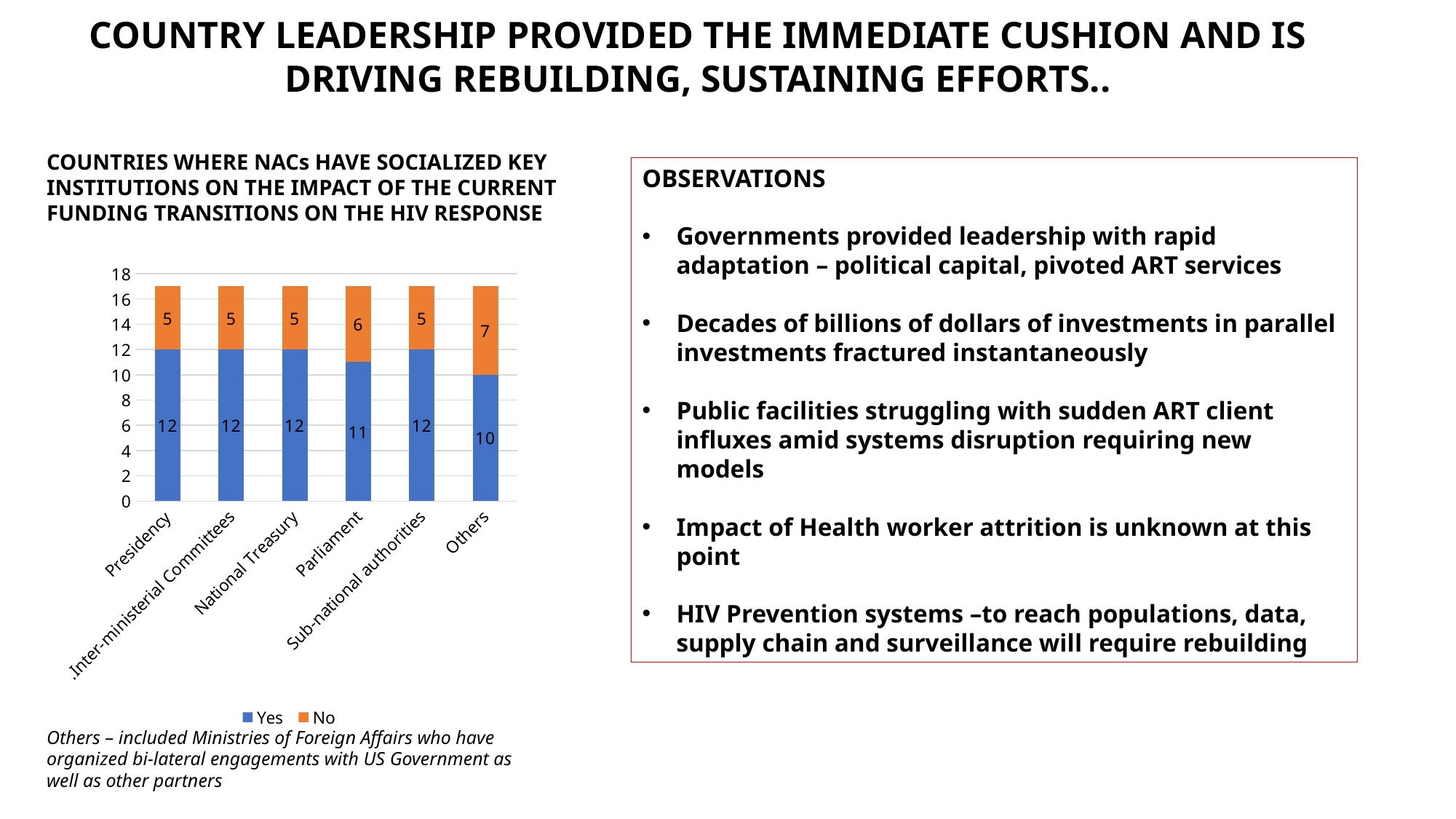
How many categories are shown on the x axis? 6 What is the 'Yes' value for Others? 10 What is the 'Yes' value for Presidency? 12 What is the 'No' value for Parliament? 6 What kind of chart is shown on the slide? Stacked bar chart What is the difference between the 'Yes' value for Presidency and the 'Yes' value for Others? 2 Which category has the highest 'No' value? Others What is the total of the stacked bar for Parliament? 17 What is the 'No' value for Others? 7 How many series does the legend list? 2 Which is larger, the 'Yes' value for Parliament or the 'Yes' value for National Treasury? National Treasury Which category has the lowest 'Yes' value? Others